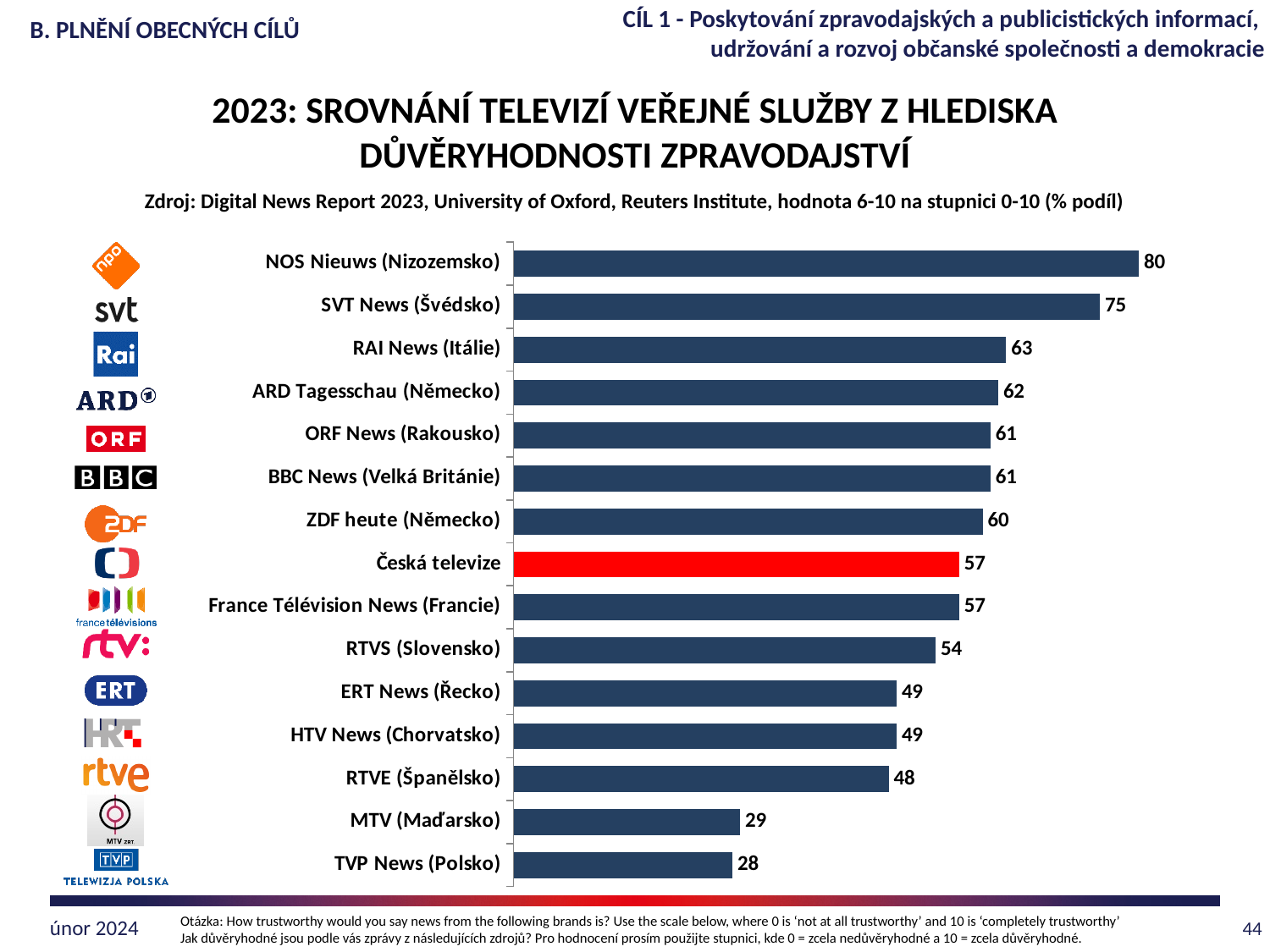
Which has a larger value, RAI News (Itálie) or ZDF heute (Německo)? RAI News (Itálie) What is the value for NOS Nieuws (Nizozemsko)? 80 What kind of chart is shown on the slide? Bar chart What is the value for Česká televize? 57 Which broadcaster has the lowest value? TVP News (Polsko) What is the difference between the values for Česká televize and MTV (Maďarsko)? 28 What is the value for RTVS (Slovensko)? 54 Which broadcaster has the highest value? NOS Nieuws (Nizozemsko) What is the difference between the values for NOS Nieuws (Nizozemsko) and SVT News (Švédsko)? 5 How many broadcasters are shown in the chart? 15 Which bar is highlighted in red? Česká televize What is the value for TVP News (Polsko)? 28